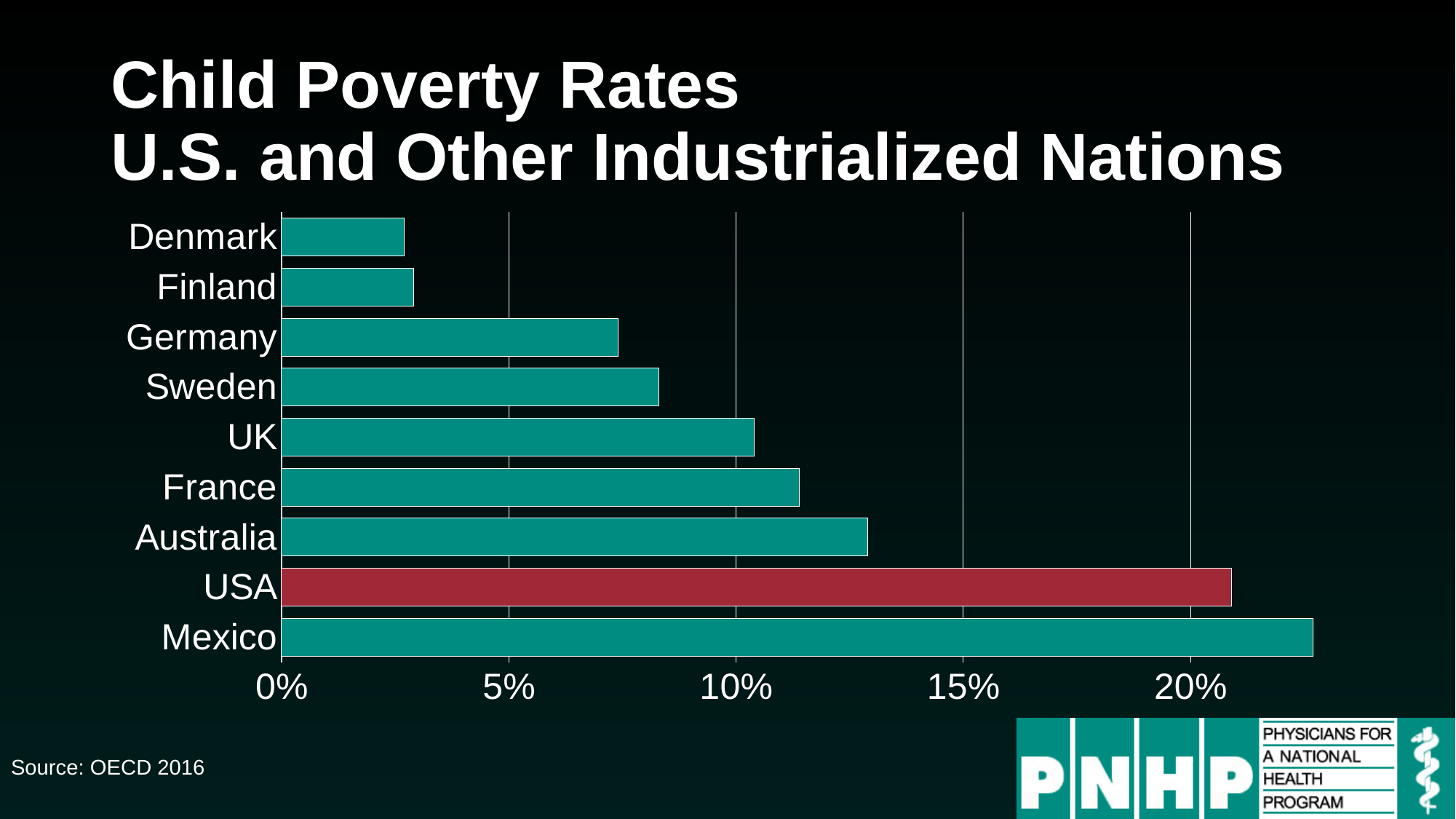
What kind of chart is shown on the slide? bar chart Is the child poverty rate for the USA greater or less than 20%? greater Is the child poverty rate for Mexico greater or less than 20%? greater Is the child poverty rate for Australia greater or less than 10%? greater Which has a higher child poverty rate, France or Finland? France Which bar is shown in a different colour (red) from the others? USA Which country has the highest child poverty rate in the chart? Mexico How many countries are shown in the chart? 9 Which has a higher child poverty rate, the USA or Australia? USA What is the source cited for the chart data? OECD 2016